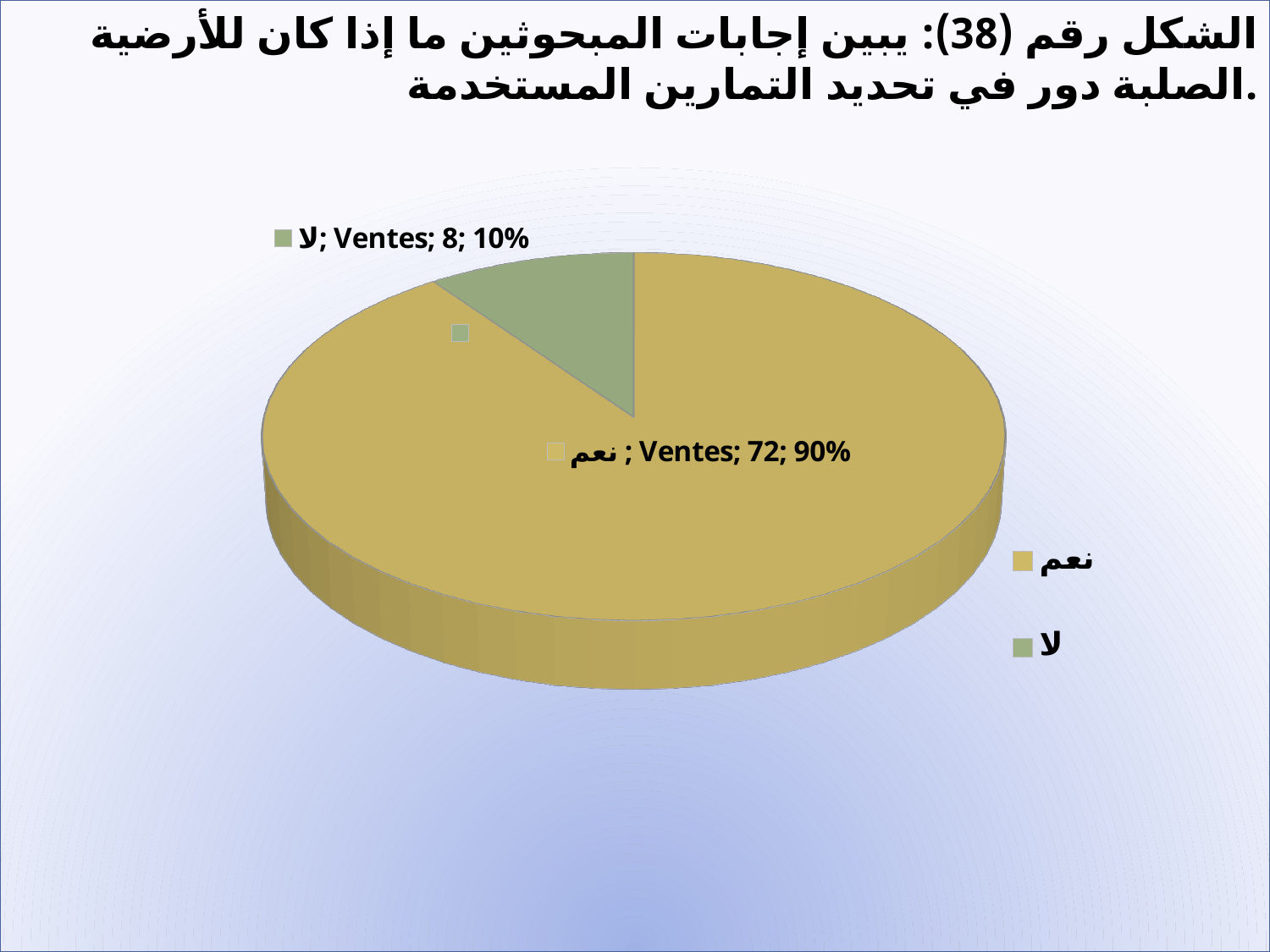
What is the total of the two slice values? 80 Which is larger, the value for نعم or the value for لا? نعم How many entries does the legend list? 2 Which category has the largest slice? نعم How many slices does the pie chart have? 2 What kind of chart is shown on the slide? pie chart What is the value for لا? 8 What is the value for نعم? 72 What is the difference between the values for نعم and لا? 64 Which category has the smallest slice? لا What percentage share does the لا slice have? 10% What percentage share does the نعم slice have? 90%